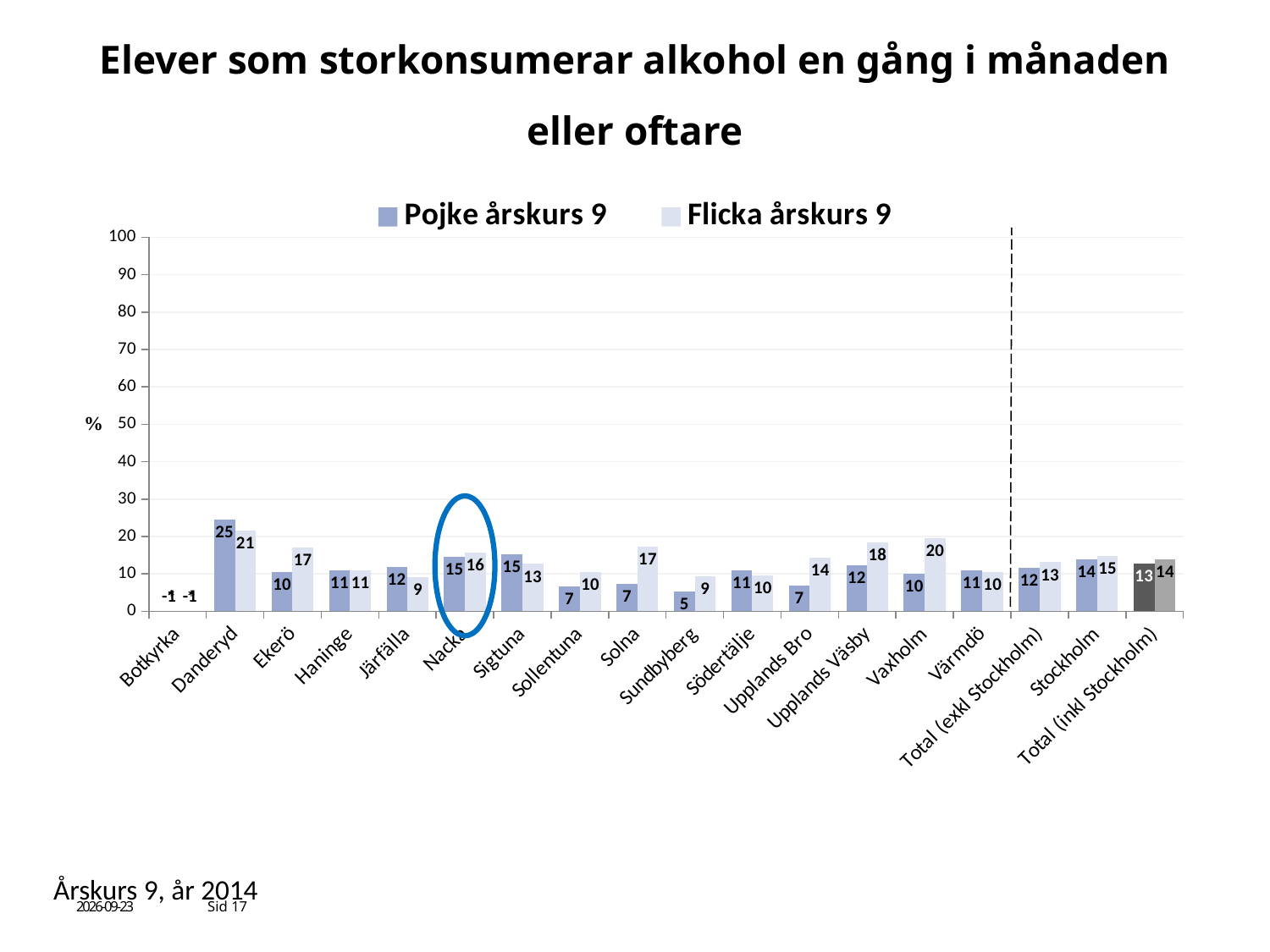
What is the value for Flicka årskurs 9 in Solna? 17 Which municipality has the lowest value for Flicka årskurs 9 among those with a plotted bar? Järfälla and Sundbyberg (both 9) Is the value for Pojke årskurs 9 in Danderyd greater or less than 20? greater Which is larger in Ekerö, the Pojke årskurs 9 value or the Flicka årskurs 9 value? Flicka årskurs 9 What is the value for Pojke årskurs 9 for Total (inkl Stockholm)? 13 How many series does the legend list? 2 Which municipality has the highest value for Pojke årskurs 9? Danderyd What type of chart is shown on the slide? bar chart What is the value for Flicka årskurs 9 in Vaxholm? 20 What is the difference between the Flicka årskurs 9 and Pojke årskurs 9 values in Vaxholm? 10 What is the value for Pojke årskurs 9 in Danderyd? 25 How many categories are shown on the x axis? 18